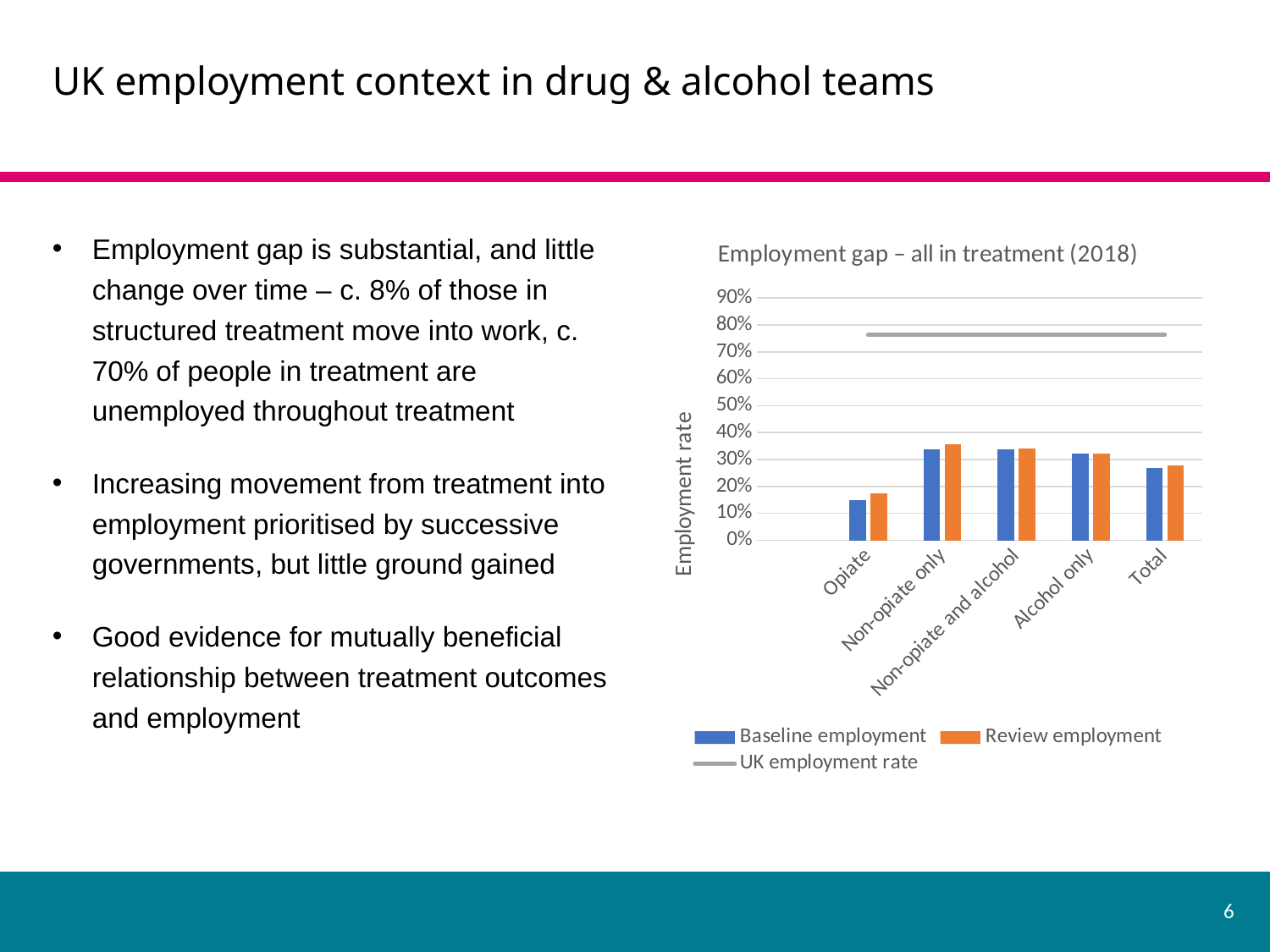
Is the Baseline employment value for Opiate greater or less than 20%? less Is the Review employment value for Non-opiate only greater or less than 30%? greater Is the Baseline employment value for Total greater or less than 30%? less Which is larger, the Review employment value for Opiate or for Total? Total How many categories are shown on the x axis of the chart? 5 What is the title of the chart? Employment gap – all in treatment (2018) How many series does the chart's legend list? 3 What kind of chart is shown on the slide? combination bar and line chart What is the label on the vertical axis of the chart? Employment rate Which category has the lowest Baseline employment value? Opiate Which is larger, the Baseline employment value for Opiate or for Non-opiate only? Non-opiate only